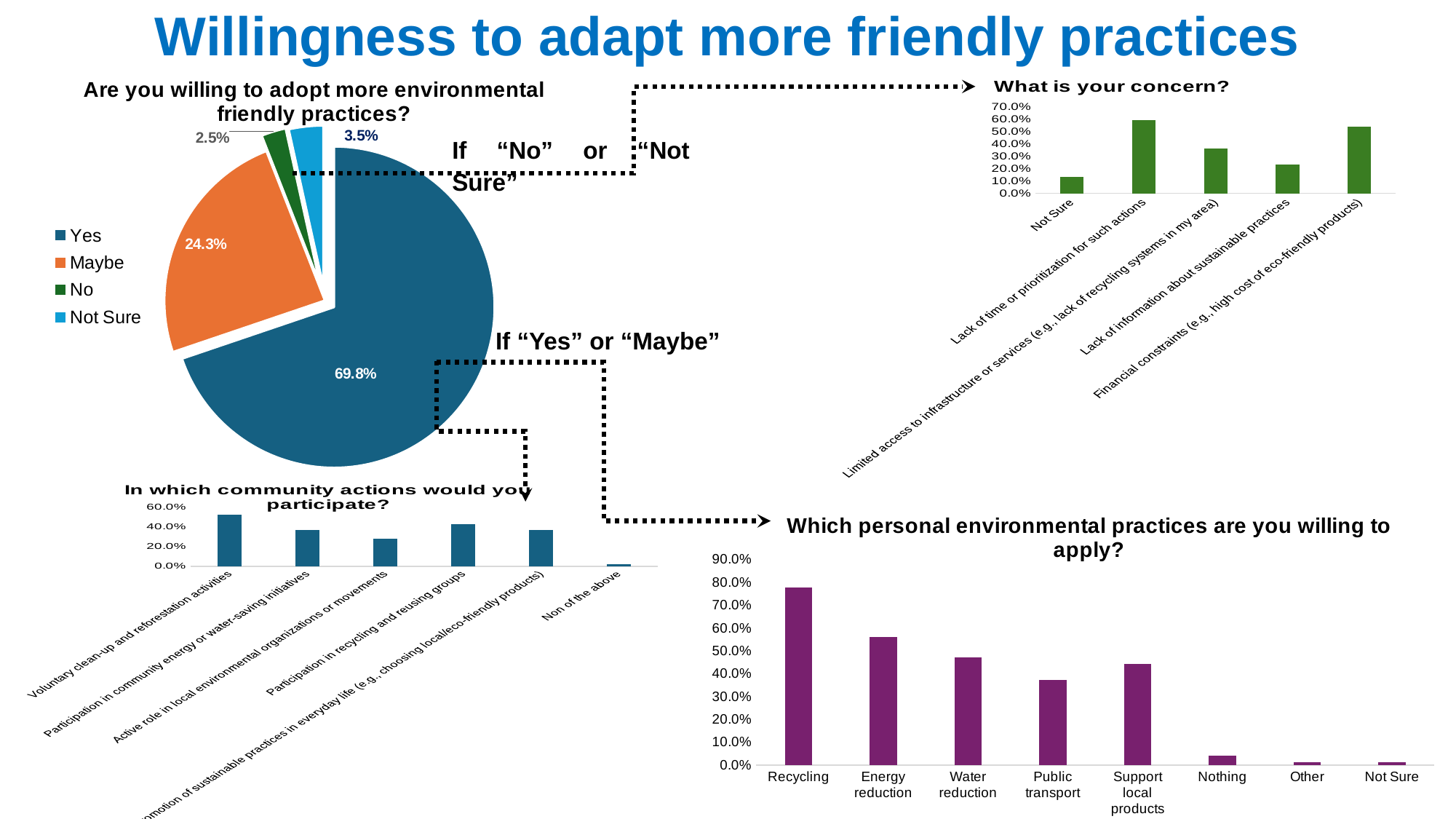
In the chart 'What is your concern?', which category has the lowest bar? Not Sure In the pie chart 'Are you willing to adopt more environmental friendly practices?', what percentage answered Maybe? 24.3% In the pie chart 'Are you willing to adopt more environmental friendly practices?', what percentage answered Yes? 69.8% In the chart 'What is your concern?', which category has the highest bar? Lack of time or prioritization for such actions How many entries does the legend of the pie chart 'Are you willing to adopt more environmental friendly practices?' list? 4 In the pie chart 'Are you willing to adopt more environmental friendly practices?', what percentage answered No? 2.5% In the pie chart 'Are you willing to adopt more environmental friendly practices?', what is the difference between the Yes and Maybe shares? 45.5% In the chart 'Which personal environmental practices are you willing to apply?', which practice has the highest bar? Recycling In the chart 'In which community actions would you participate?', which category has the lowest bar? Non of the above In the pie chart 'Are you willing to adopt more environmental friendly practices?', which response has the smallest slice? No In the chart 'What is your concern?', is the value for 'Financial constraints (e.g., high cost of eco-friendly products)' greater or less than 40.0%? greater In the chart 'Which personal environmental practices are you willing to apply?', is the value for Energy reduction greater or less than 50.0%? greater